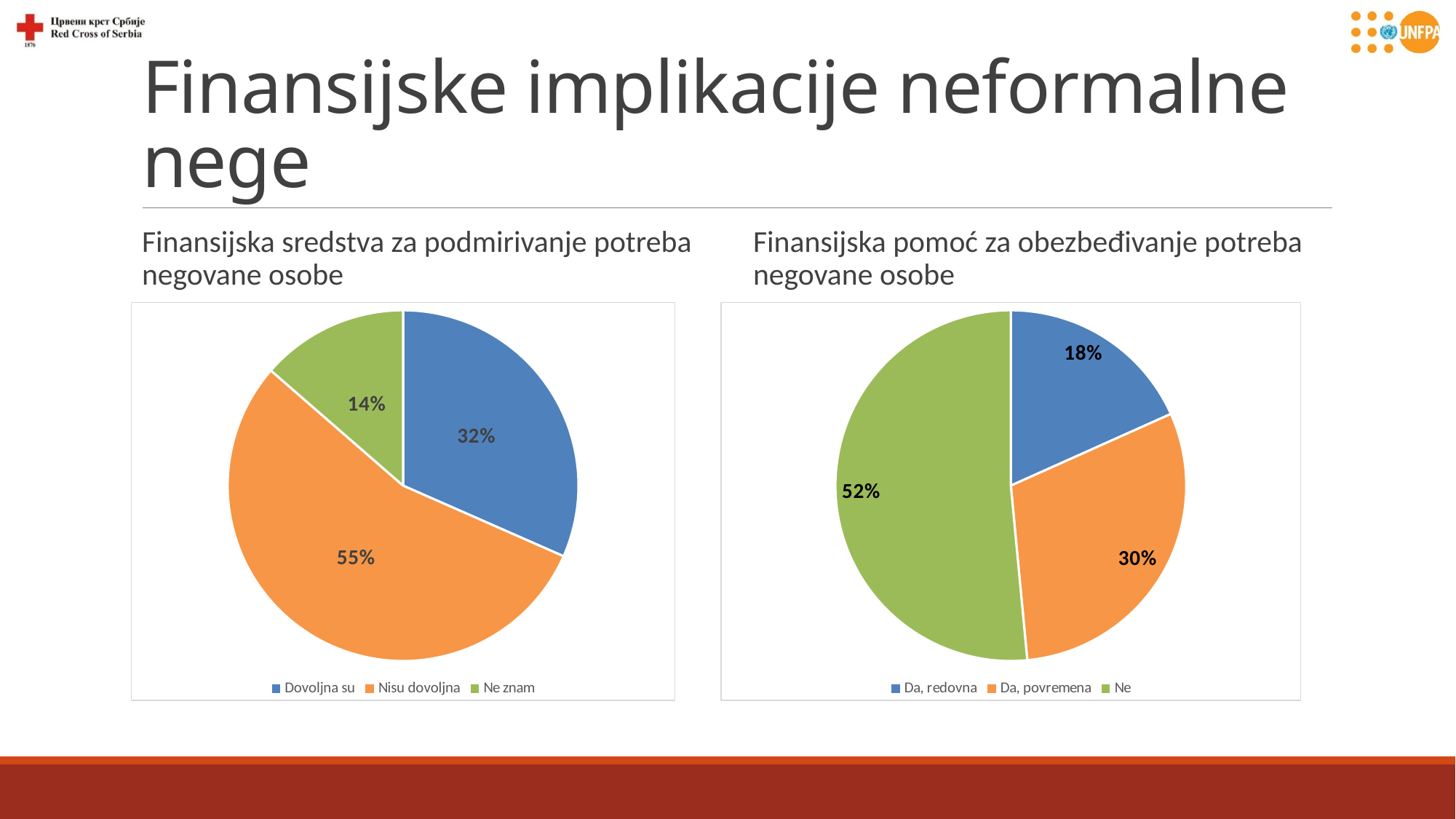
In the right pie chart (Finansijska pomoć za obezbeđivanje potreba negovane osobe), what share is labelled for 'Da, redovna'? 18% What type of chart is used on the right side of the slide (Finansijska pomoć za obezbeđivanje potreba negovane osobe)? Pie chart In the right pie chart (Finansijska pomoć za obezbeđivanje potreba negovane osobe), which category has the largest slice? Ne In the left pie chart (Finansijska sredstva za podmirivanje potreba negovane osobe), which category has the smallest slice? Ne znam In the left pie chart (Finansijska sredstva za podmirivanje potreba negovane osobe), what share is labelled for 'Nisu dovoljna'? 55% In the right pie chart (Finansijska pomoć za obezbeđivanje potreba negovane osobe), which is larger: 'Da, povremena' or 'Da, redovna'? Da, povremena In the left pie chart (Finansijska sredstva za podmirivanje potreba negovane osobe), what share is labelled for 'Dovoljna su'? 32% In the right pie chart (Finansijska pomoć za obezbeđivanje potreba negovane osobe), what share is labelled for 'Ne'? 52% In the right pie chart (Finansijska pomoć za obezbeđivanje potreba negovane osobe), what colour is the 'Ne' slice? Green In the right pie chart (Finansijska pomoć za obezbeđivanje potreba negovane osobe), what is the difference between the 'Ne' and 'Da, povremena' shares? 22% In the left pie chart (Finansijska sredstva za podmirivanje potreba negovane osobe), how many slices does the pie have? 3 In the left pie chart (Finansijska sredstva za podmirivanje potreba negovane osobe), what is the difference between the 'Nisu dovoljna' and 'Dovoljna su' shares? 23%